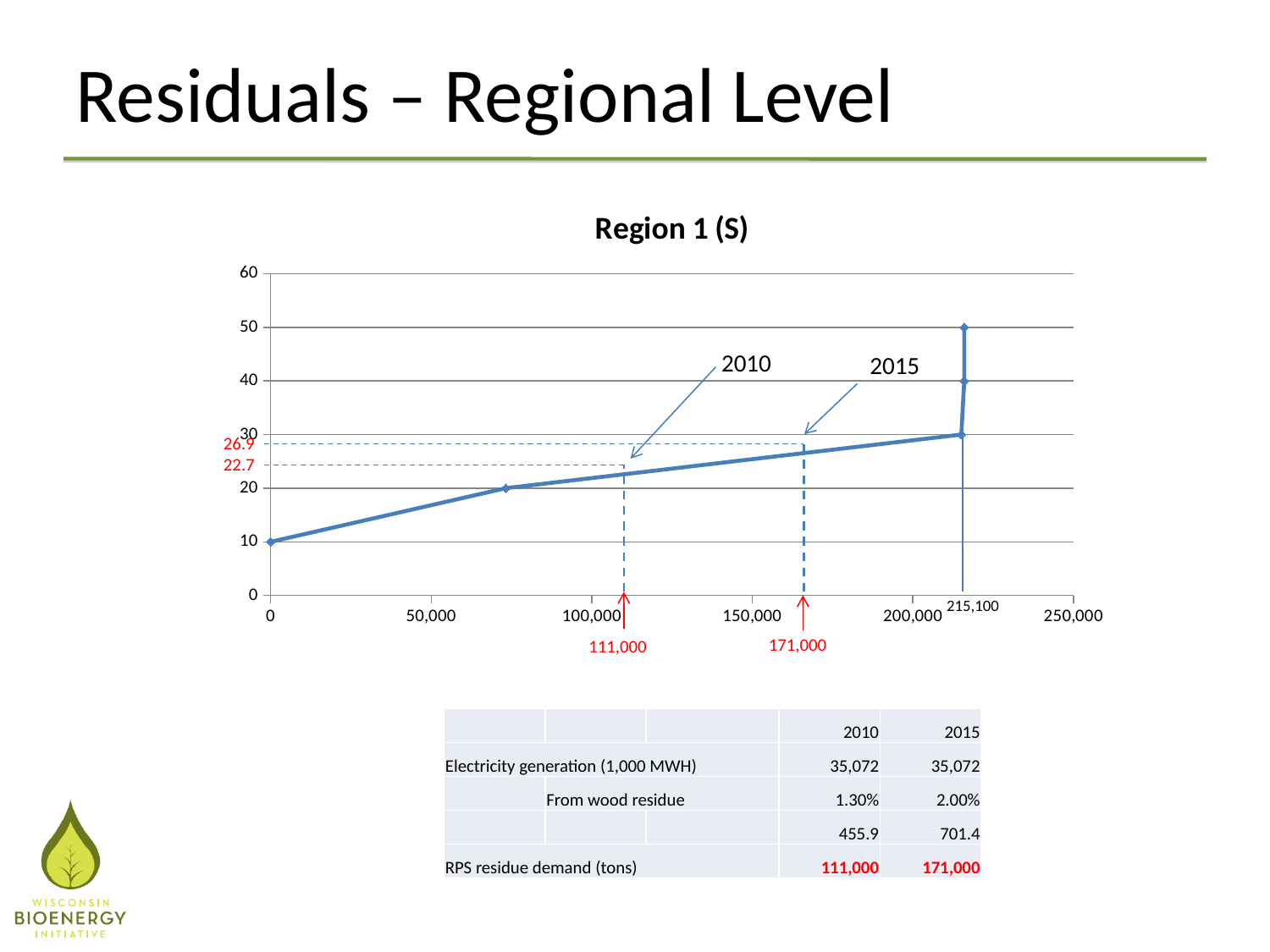
What y-axis value is marked for the 2015 point on the chart? 26.9 What x-axis value is labelled where the curve turns vertical? 215,100 What x-axis value is marked for 2010 on the chart? 111,000 What x-axis value is marked for 2015 on the chart? 171,000 What is the difference between the x-axis values marked for 2015 and 2010? 60,000 What is the difference between the y-axis values marked for 2015 and 2010? 4.2 Is the y value of the 2010 point greater or less than 20? greater What is the title of the chart? Region 1 (S) Which year has the larger marked x-axis value, 2010 or 2015? 2015 Does the curve rise or fall as the x-axis value increases? rise What y-axis value is marked for the 2010 point on the chart? 22.7 What kind of chart is shown on the slide? line chart